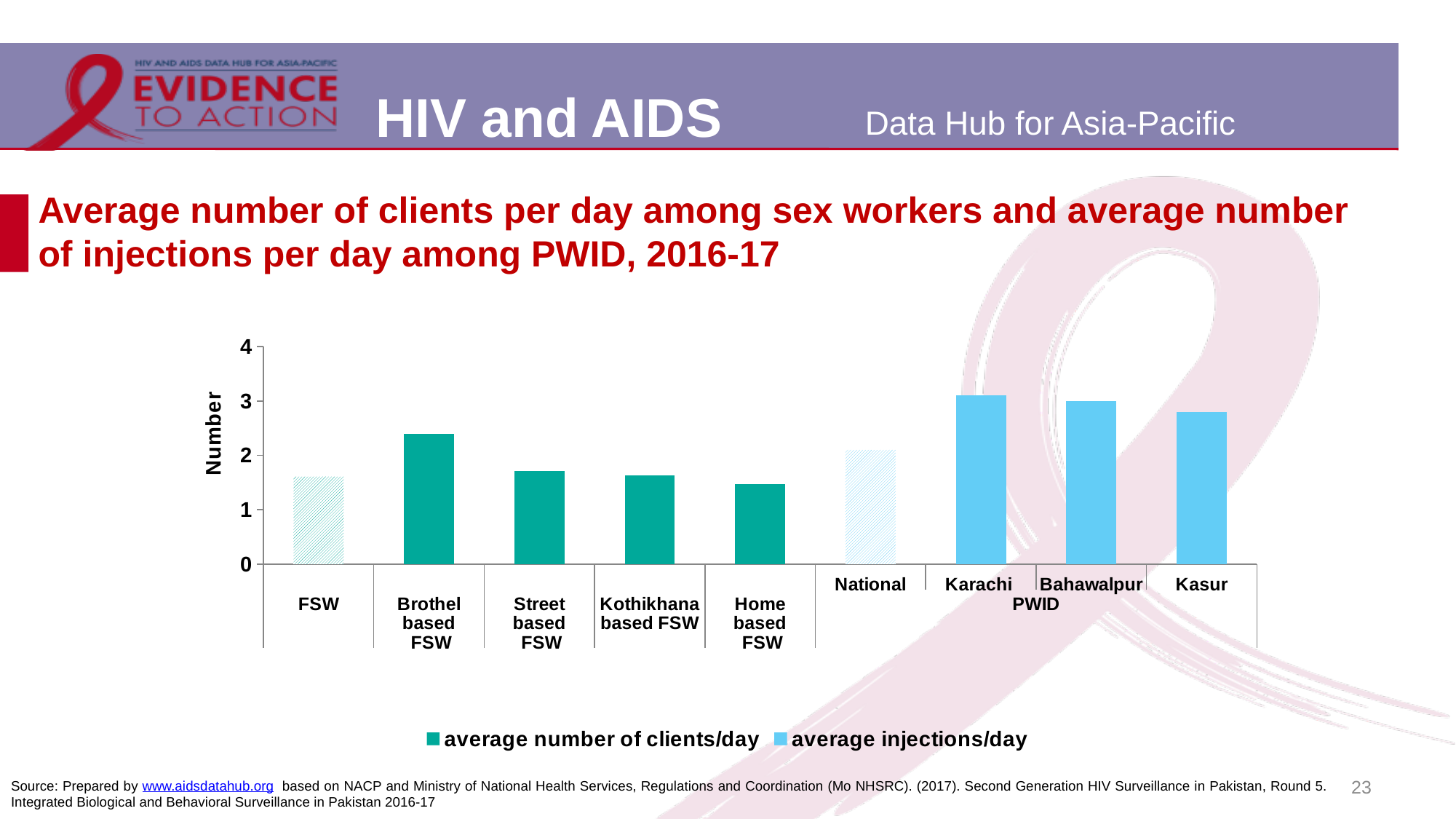
Is the value for Home based FSW greater or less than 2? less Is the value for Bahawalpur greater or less than 2? greater Is the value for Street based FSW greater or less than 2? less Which is larger, the value for Karachi or the value for Kasur? Karachi What is the title of the vertical axis? Number How many bars are plotted in the chart? 9 How many series does the legend list? 2 Which is larger, the value for Brothel based FSW or the value for Home based FSW? Brothel based FSW Among the 'average number of clients/day' bars, which category is the highest? Brothel based FSW What kind of chart is shown on the slide? bar chart